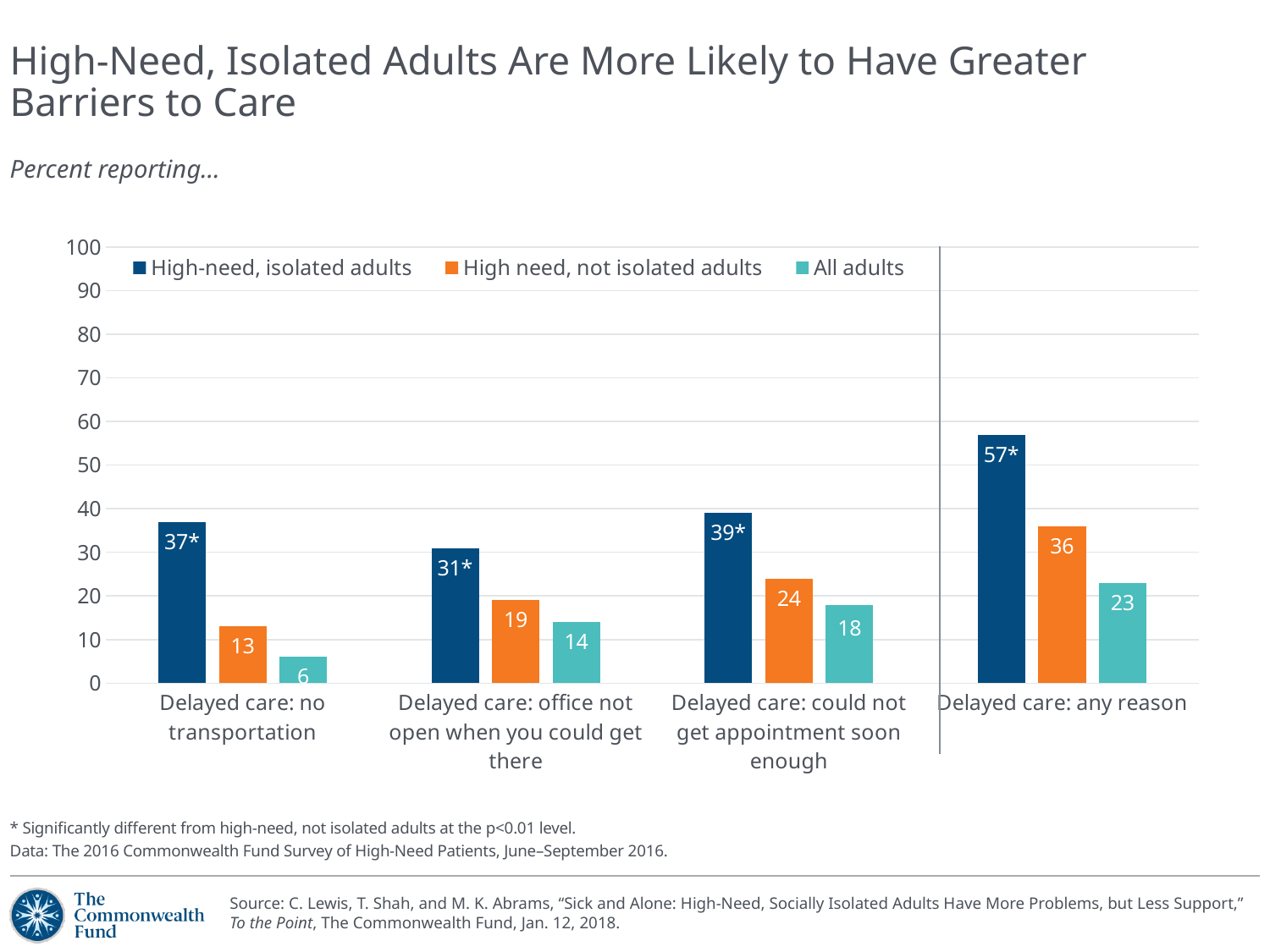
Which category has the lowest value for All adults? Delayed care: no transportation What is the value for All adults in the 'Delayed care: office not open when you could get there' category? 14 Which is larger in the 'Delayed care: office not open when you could get there' category: High need, not isolated adults or All adults? High need, not isolated adults What is the value for All adults in the 'Delayed care: no transportation' category? 6 What is the value for High-need, isolated adults in the 'Delayed care: any reason' category? 57* How many series does the legend list? 3 What is the value for High need, not isolated adults in the 'Delayed care: could not get appointment soon enough' category? 24 Which series is shown in orange in the legend? High need, not isolated adults What kind of chart is shown on the slide? Bar chart How many categories are shown on the x axis? 4 Which category has the highest value for High-need, isolated adults? Delayed care: any reason What is the difference between High-need, isolated adults and High need, not isolated adults in the 'Delayed care: any reason' category? 21